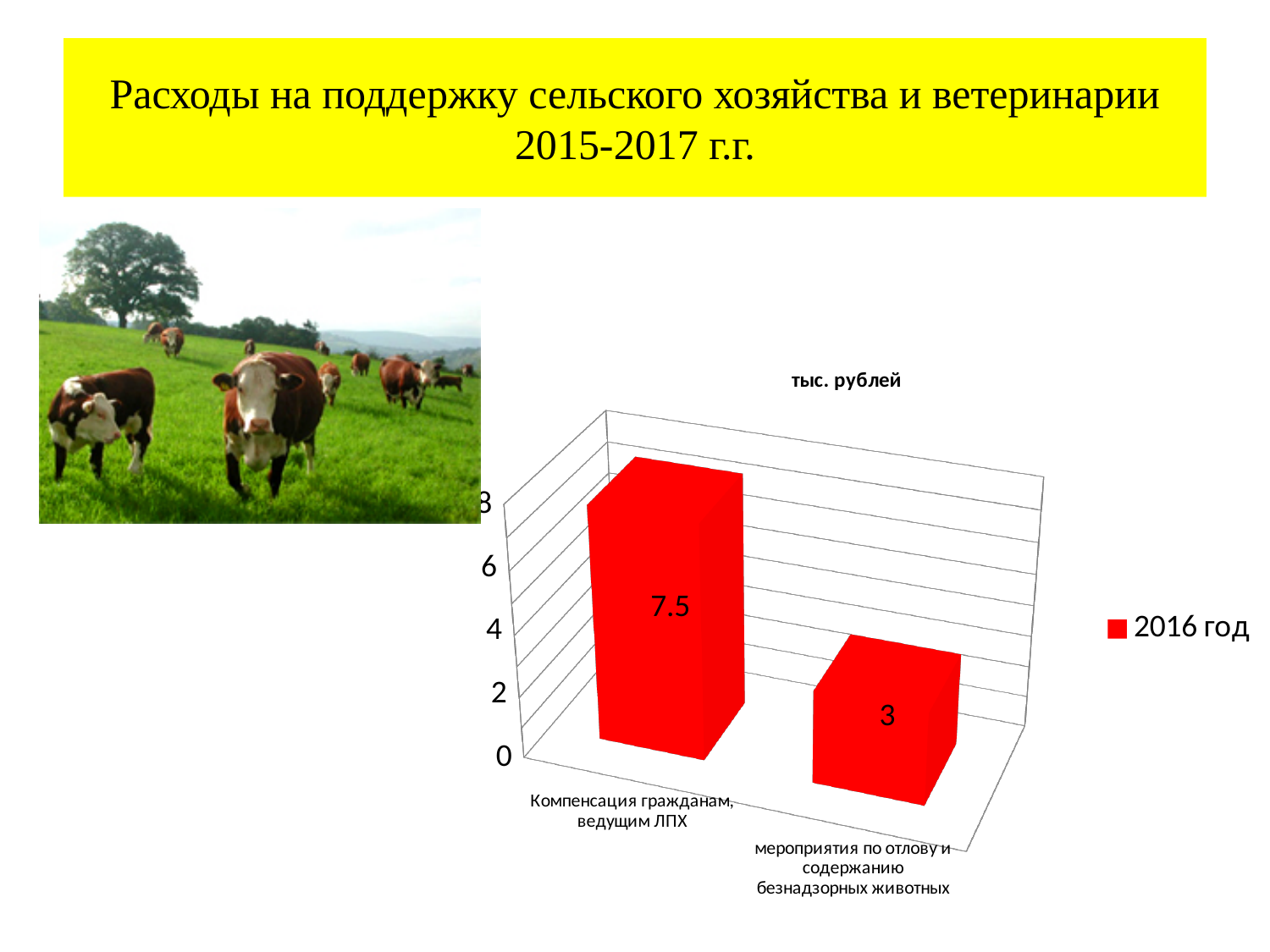
What is the difference between the value for "Компенсация гражданам, ведущим ЛПХ" and the value for "мероприятия по отлову и содержанию безнадзорных животных"? 4.5 Which is larger: the value for "Компенсация гражданам, ведущим ЛПХ" or the value for "мероприятия по отлову и содержанию безнадзорных животных"? Компенсация гражданам, ведущим ЛПХ What series name is shown in the chart legend? 2016 год Is the value for "Компенсация гражданам, ведущим ЛПХ" greater or less than 6? greater Which category has the highest value? Компенсация гражданам, ведущим ЛПХ Which category has the lowest value? мероприятия по отлову и содержанию безнадзорных животных What is the value for "мероприятия по отлову и содержанию безнадзорных животных"? 3 What kind of chart is shown on the slide? bar chart How many series does the legend list? 1 How many categories are shown in the chart? 2 Is the value for "мероприятия по отлову и содержанию безнадзорных животных" greater or less than 4? less What is the value for "Компенсация гражданам, ведущим ЛПХ"? 7.5